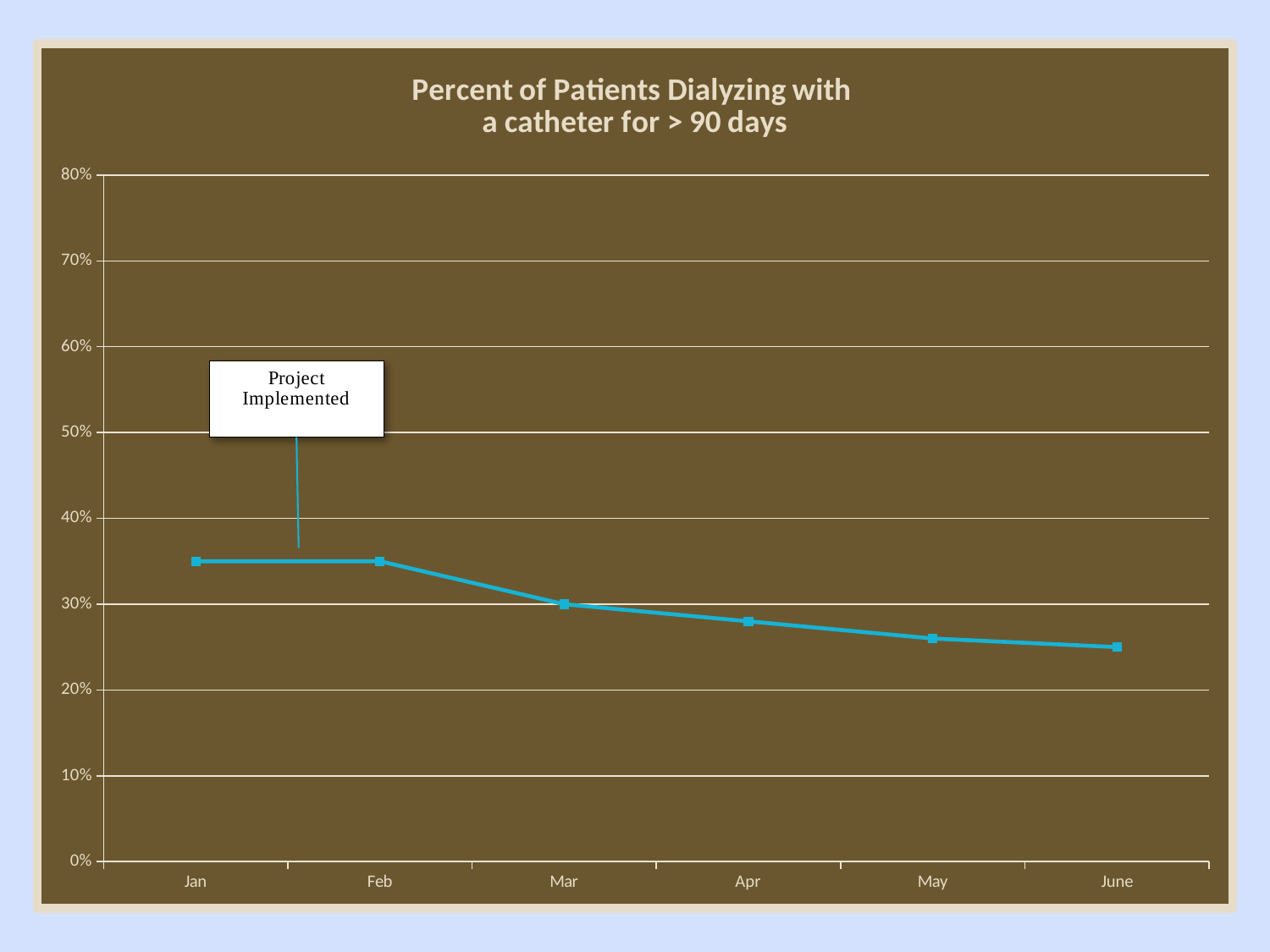
Which is larger, the value for Mar or the value for June? Mar What kind of chart is shown on the slide? line chart How many months are plotted along the x axis? 6 Is the value for Feb greater or less than 30%? greater Do the values rise or fall from Jan to June? fall What does the text box annotation on the chart say? Project Implemented What is the value for Mar? 30% Is the value for June greater or less than 30%? less Is the value for Jan greater or less than 40%? less Which is larger, the value for Feb or the value for Mar? Feb